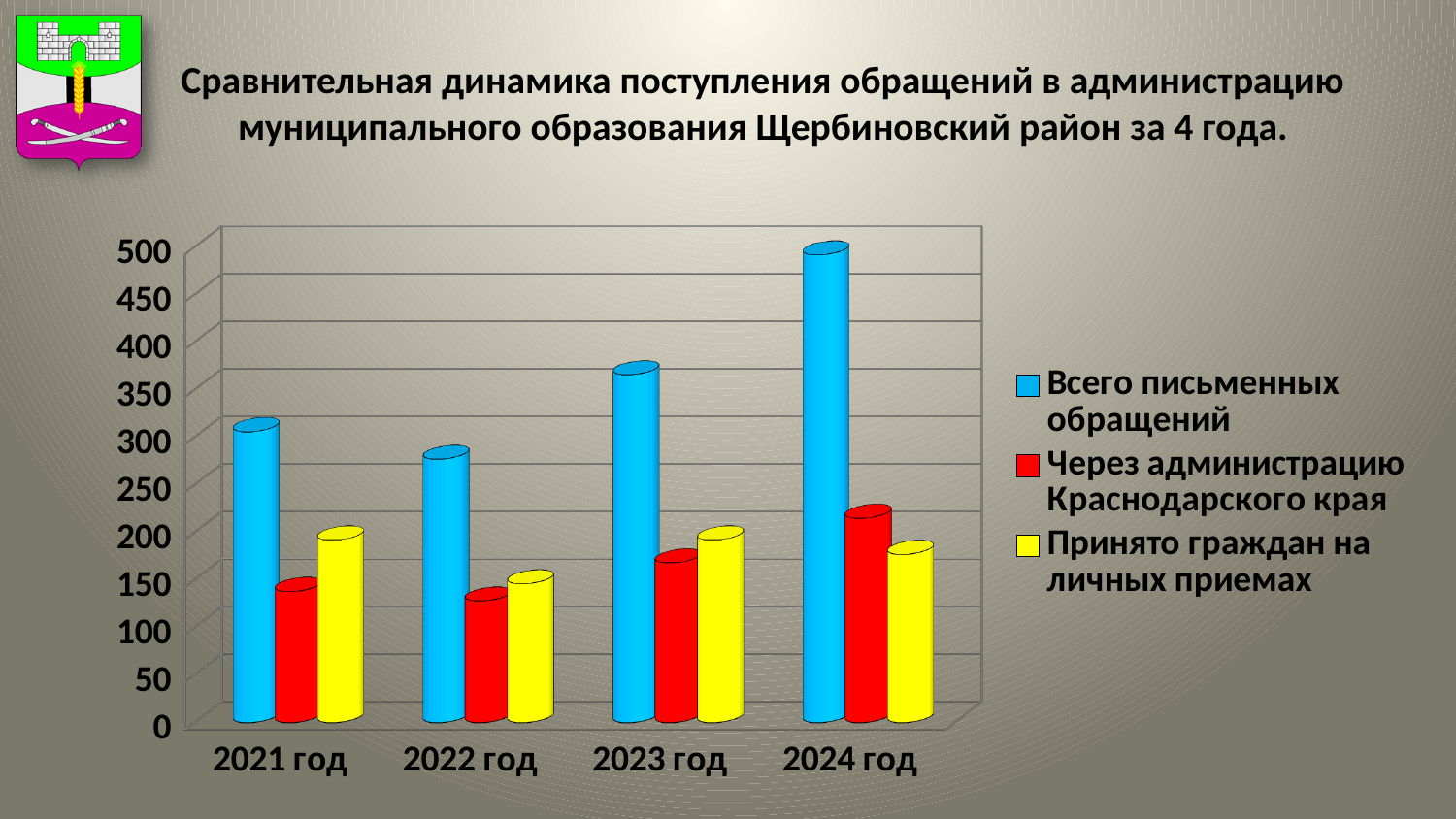
How many years (categories) are shown on the x axis? 4 What kind of chart is shown on the slide? bar chart Which is larger for "Всего письменных обращений": 2021 год or 2023 год? 2023 год Which colour represents the series "Принято граждан на личных приемах"? yellow Which is larger in 2024 год: "Через администрацию Краснодарского края" or "Принято граждан на личных приемах"? Через администрацию Краснодарского края In which year is the value for "Всего письменных обращений" the lowest? 2022 год Is the value for "Всего письменных обращений" in 2024 год greater or less than 450? greater Is the value for "Через администрацию Краснодарского края" in 2022 год greater or less than 150? less Do the values for "Всего письменных обращений" rise or fall from 2022 год to 2024 год? rise In which year is the value for "Всего письменных обращений" the highest? 2024 год Is the value for "Всего письменных обращений" in 2023 год greater or less than 350? greater How many series does the legend list? 3